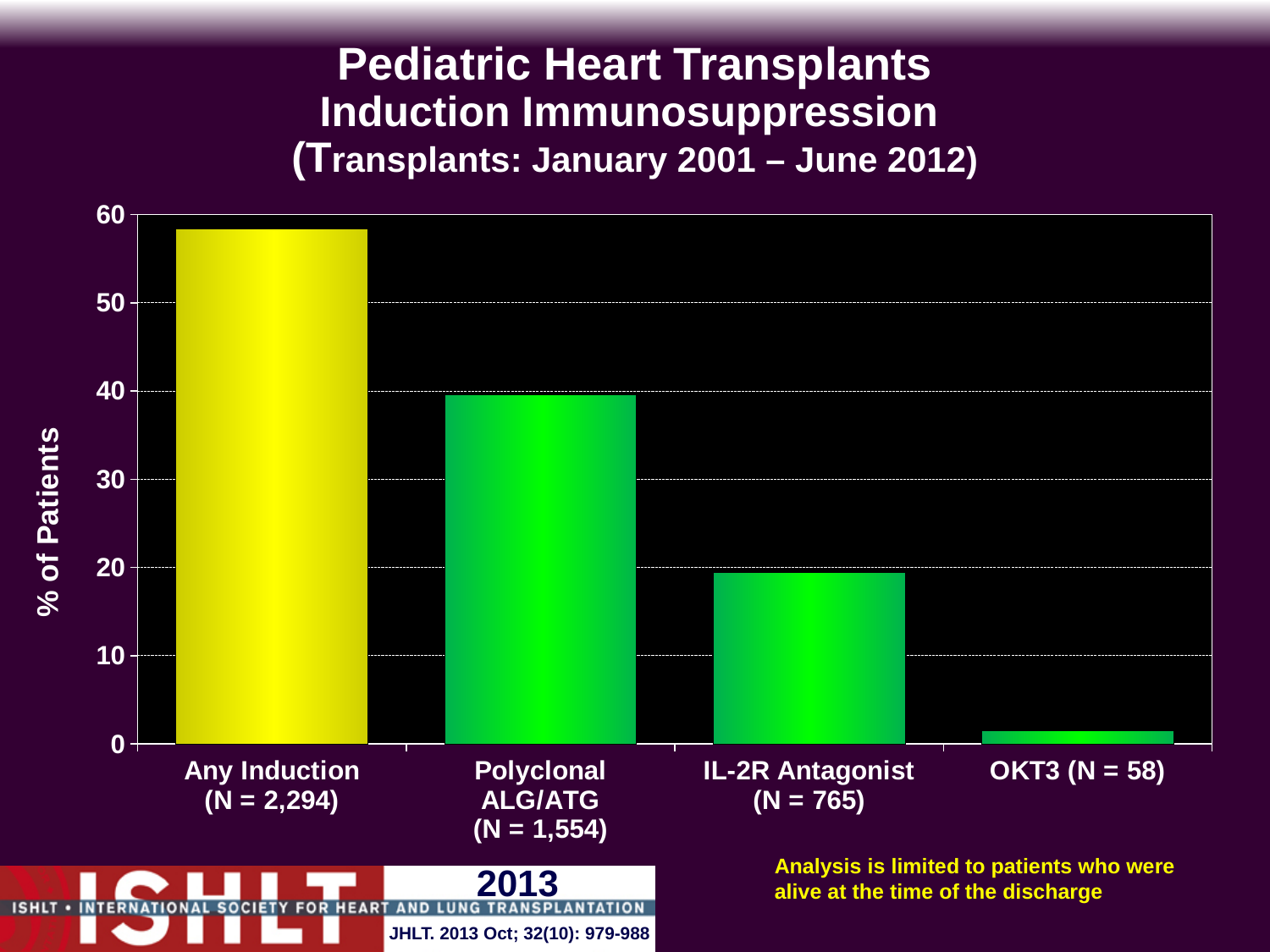
Which is larger, the value for Polyclonal ALG/ATG or the value for IL-2R Antagonist? Polyclonal ALG/ATG Which category has the highest percentage of patients? Any Induction What kind of chart is shown on the slide? bar chart Is the value for OKT3 greater or less than 10? less Is the value for Polyclonal ALG/ATG greater or less than 30? greater Do the bar values rise or fall from left to right across the categories? fall Is the value for Any Induction greater or less than 50? greater Which category has the lowest percentage of patients? OKT3 What is the N shown for the Polyclonal ALG/ATG category? 1,554 How many categories are plotted on the chart? 4 What is the label on the vertical axis of the chart? % of Patients